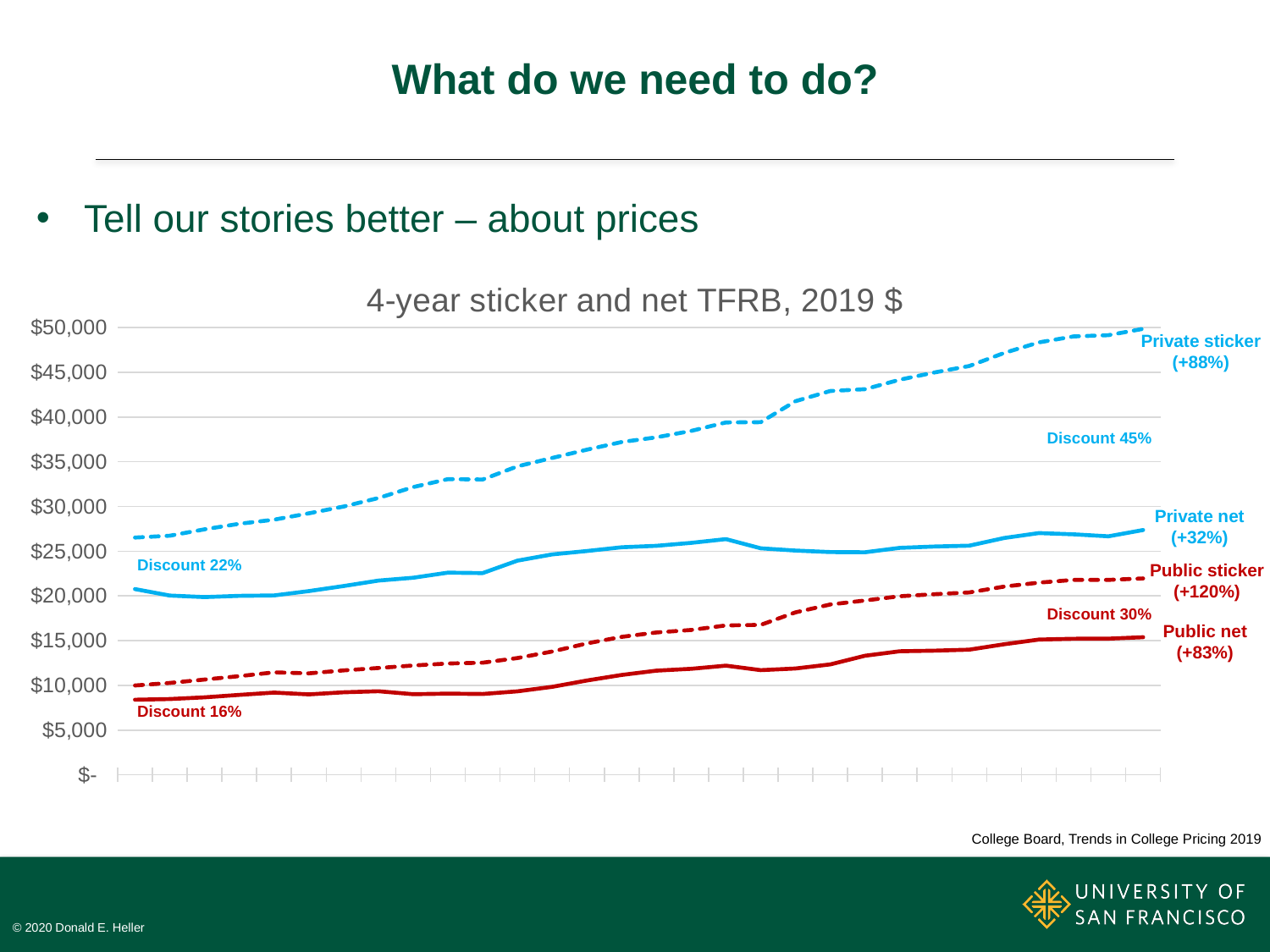
How many series are plotted on the chart? 4 What is the title of the chart? 4-year sticker and net TFRB, 2019 $ What discount percentage is labelled at the end of the private lines? 45% What percentage increase is shown for the Public net series? +83% Which series has the lowest values across the chart? Public net Does the Private sticker series rise or fall from left to right? rise Is the value for Private sticker at the left end of the chart greater or less than $25,000? greater What percentage increase is shown for the Public sticker series? +120% Which series has the highest values at the right end of the chart? Private sticker What kind of chart is shown on the slide? line chart Is the value for Public net at the left end of the chart greater or less than $10,000? less What percentage increase is shown for the Private sticker series? +88%